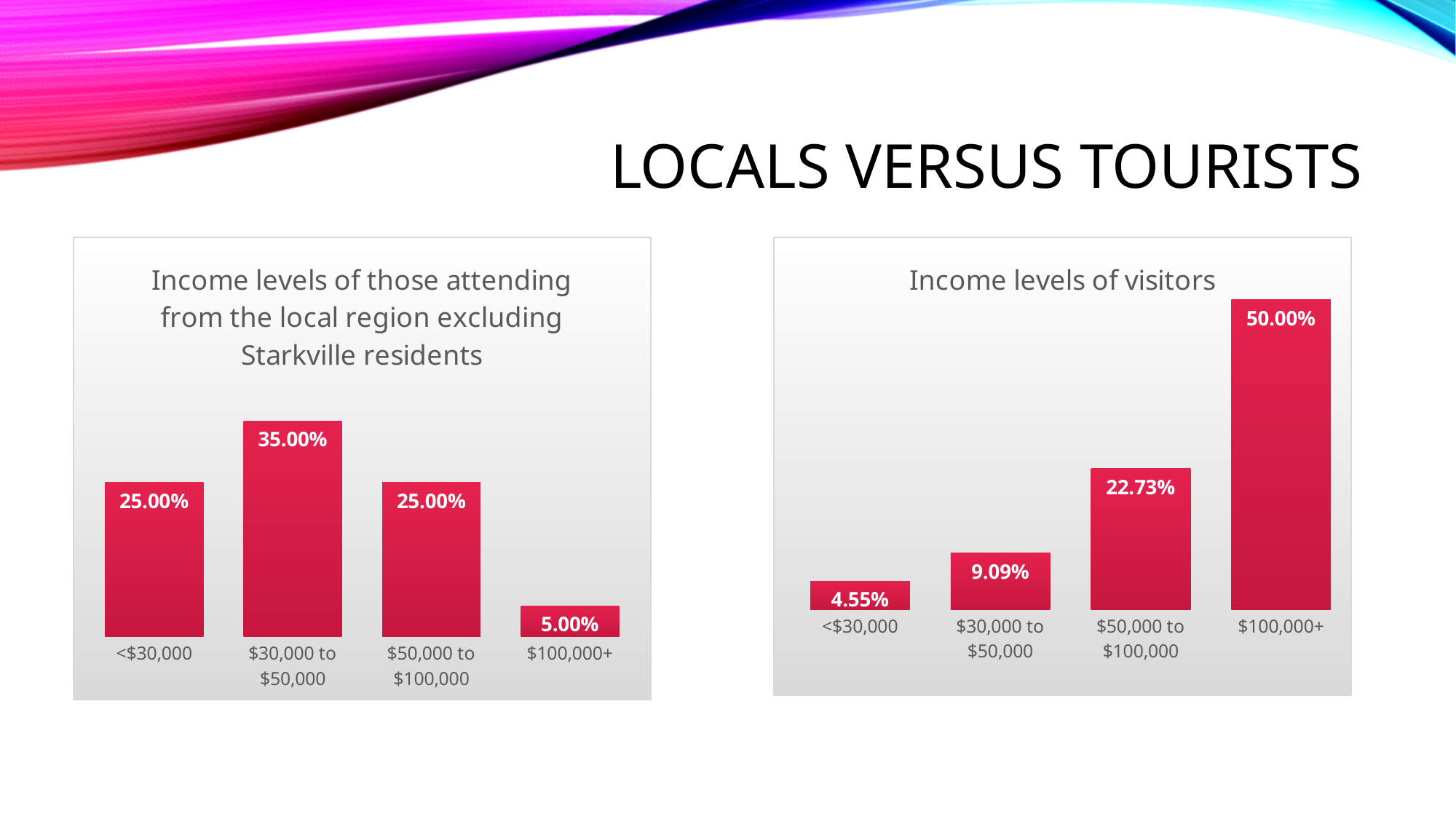
In the left chart (Income levels of those attending from the local region excluding Starkville residents), what is the value for $100,000+? 5.00% In the left chart (Income levels of those attending from the local region excluding Starkville residents), what is the difference between the values for $30,000 to $50,000 and $100,000+? 30.00% In the left chart (Income levels of those attending from the local region excluding Starkville residents), which income category has the lowest value? $100,000+ In the right chart (Income levels of visitors), do the values rise or fall from left to right along the x axis? Rise In the right chart (Income levels of visitors), which income category has the highest value? $100,000+ In the right chart (Income levels of visitors), what is the value for $50,000 to $100,000? 22.73% In the left chart (Income levels of those attending from the local region excluding Starkville residents), what is the value for $30,000 to $50,000? 35.00% What type of chart is the left chart (Income levels of those attending from the local region excluding Starkville residents)? Bar chart In the right chart (Income levels of visitors), what is the value for <$30,000? 4.55% How many income categories are shown in the right chart (Income levels of visitors)? 4 In the right chart (Income levels of visitors), what is the difference between the values for $100,000+ and $30,000 to $50,000? 40.91% Which is larger: the value for $100,000+ in the left chart or the value for $100,000+ in the right chart? The right chart (Income levels of visitors)